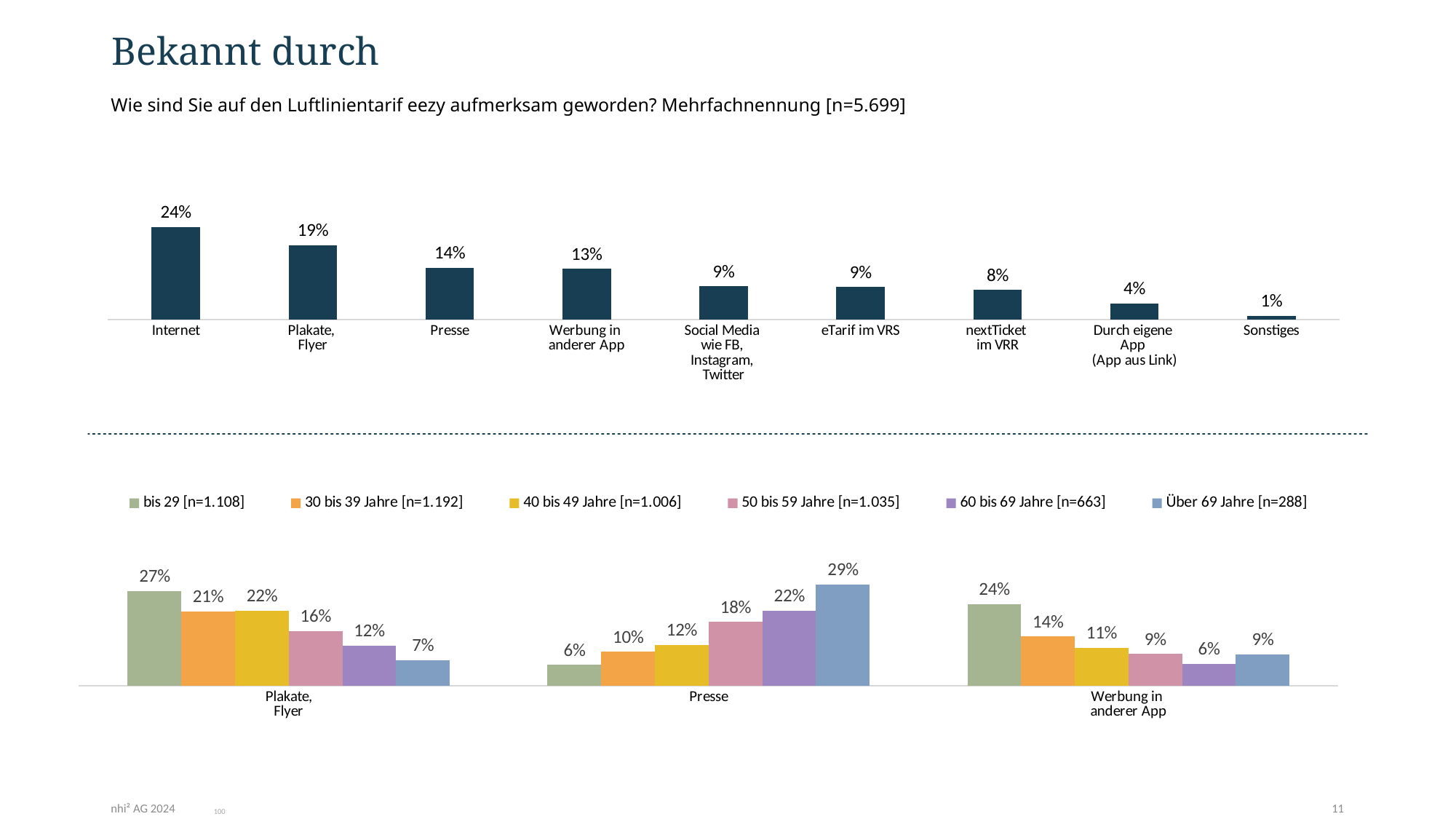
In the top chart, what is the value for Internet? 24% What kind of chart is the top chart? Bar chart In the bottom chart, how many series does the legend list? 6 In the top chart, how many categories are shown? 9 In the top chart, which category has the lowest value? Sonstiges In the bottom chart, which is larger for Werbung in anderer App: bis 29 or 30 bis 39 Jahre? bis 29 In the bottom chart, what is the difference between bis 29 and Über 69 Jahre in the Presse category? 23% In the top chart, what is the difference between Plakate, Flyer and Presse? 5% In the top chart, which category has the highest value? Internet In the bottom chart, which age group has the highest value for Plakate, Flyer? bis 29 [n=1.108] In the top chart, what is the value for nextTicket im VRR? 8% In the bottom chart, what is the value for Über 69 Jahre in the Presse category? 29%